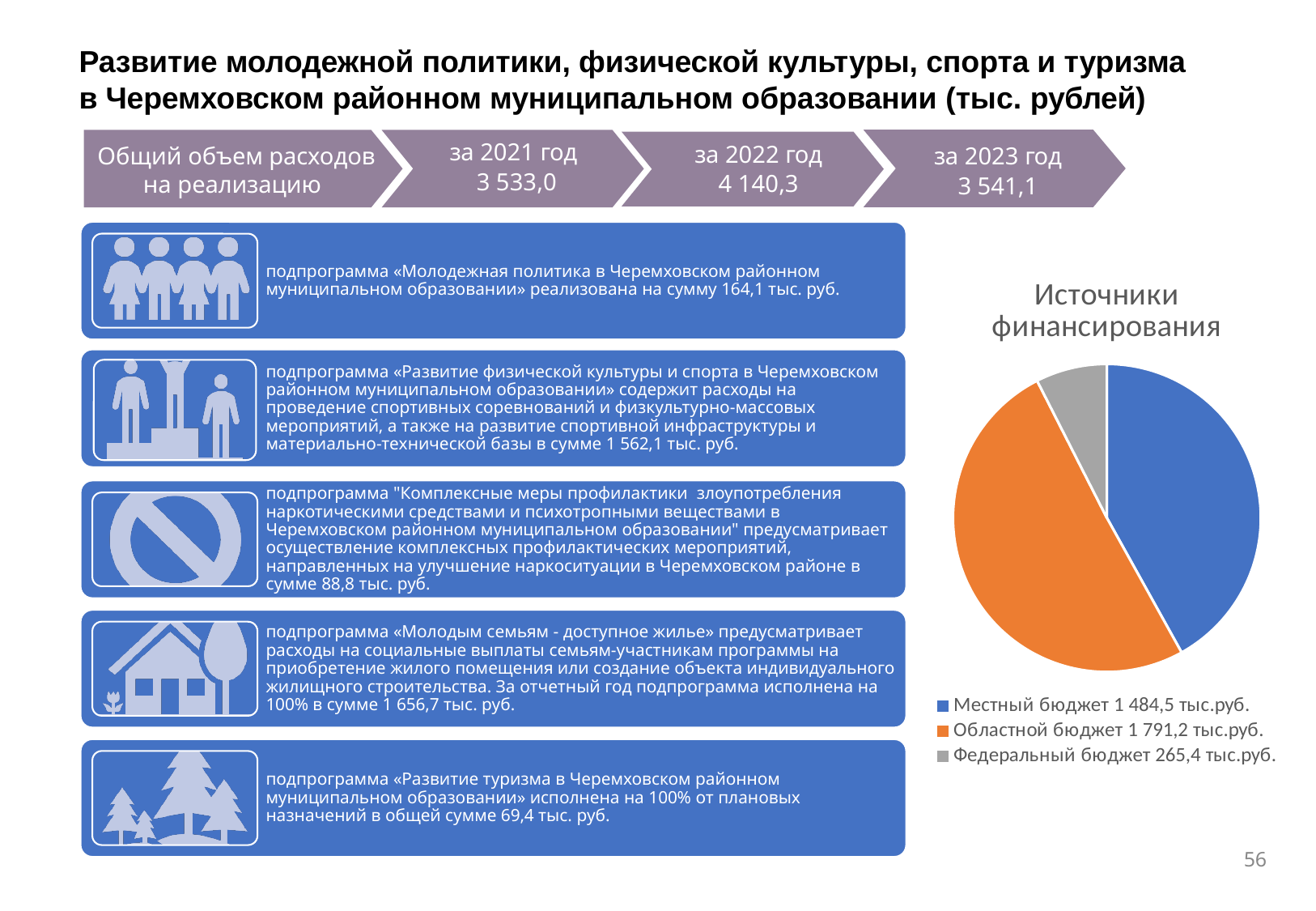
Какая сумма приходится на местный бюджет по диаграмме «Источники финансирования»? 1 484,5 тыс.руб. На сколько областной бюджет превышает местный бюджет по диаграмме «Источники финансирования»? 306,7 тыс.руб. Какой источник финансирования имеет наибольшую долю на круговой диаграмме? Областной бюджет Каким цветом на круговой диаграмме обозначен федеральный бюджет? Серым Какой источник финансирования имеет наименьшую долю на круговой диаграмме? Федеральный бюджет Какая сумма приходится на федеральный бюджет по диаграмме «Источники финансирования»? 265,4 тыс.руб. На сколько местный бюджет превышает федеральный бюджет по диаграмме «Источники финансирования»? 1 219,1 тыс.руб. Сколько категорий (источников финансирования) показано на круговой диаграмме? 3 Какая сумма приходится на областной бюджет по диаграмме «Источники финансирования»? 1 791,2 тыс.руб. Что больше по диаграмме «Источники финансирования»: местный бюджет или областной бюджет? Областной бюджет Какова общая сумма всех источников финансирования на круговой диаграмме? 3 541,1 тыс.руб. Какой тип диаграммы показан на слайде под заголовком «Источники финансирования»? Круговая диаграмма